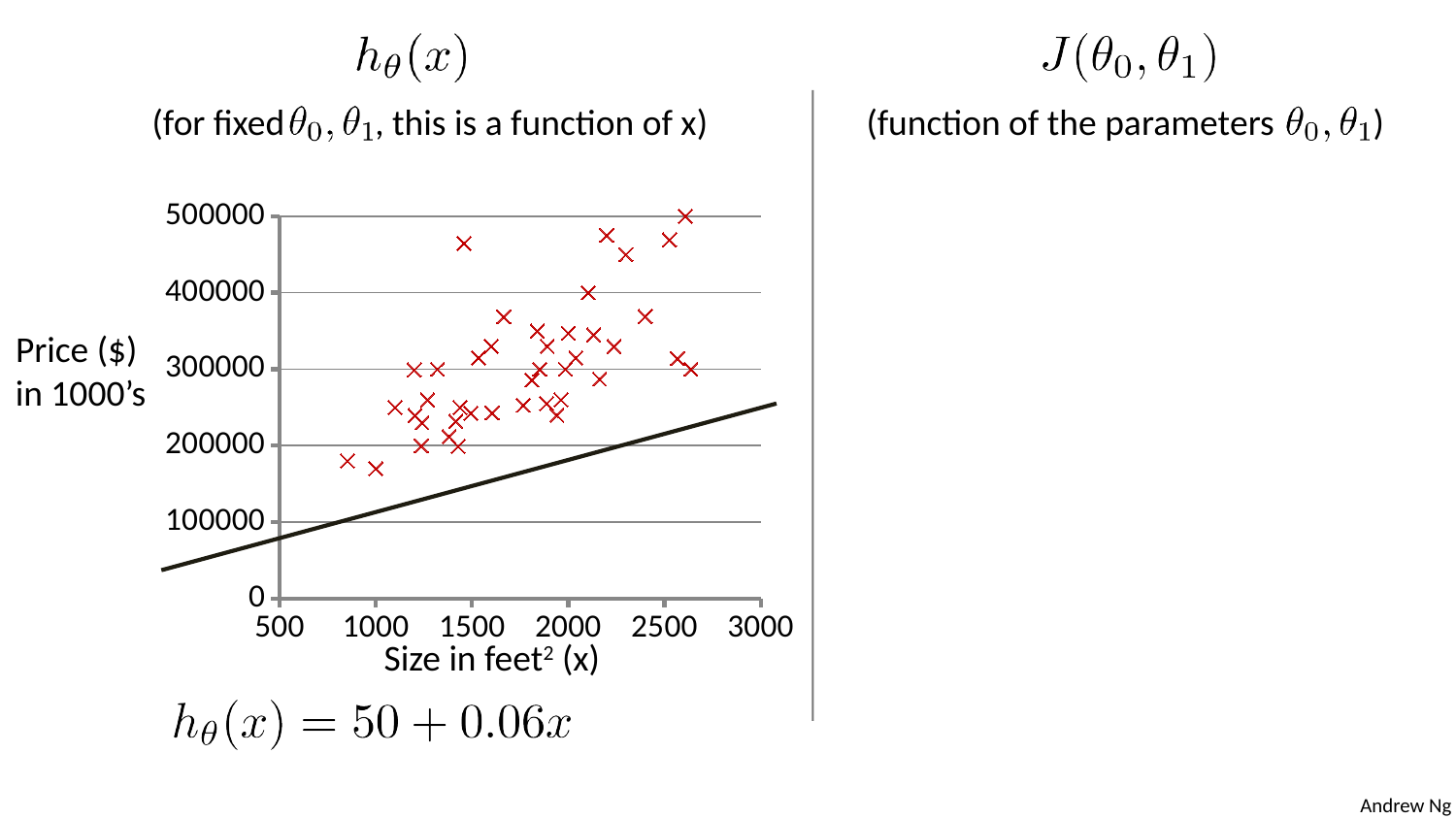
Is the highest plotted data point greater or less than 400000? greater What equation for the hypothesis is written below the chart? hθ(x) = 50 + 0.06x What is the highest value shown on the x axis of the chart? 3000 Is the lowest plotted data point greater or less than 200000? less Is the value of the fitted line at x = 3000 greater or less than 300000? less What is the highest value shown on the y axis of the chart? 500000 What is the lowest value shown on the x axis of the chart? 500 What is the label of the x axis of the chart? Size in feet² (x) What kind of chart is shown on the slide? scatter chart Do the plotted prices generally rise or fall as size increases along the x axis? rise What is the label of the y axis of the chart? Price ($) in 1000's